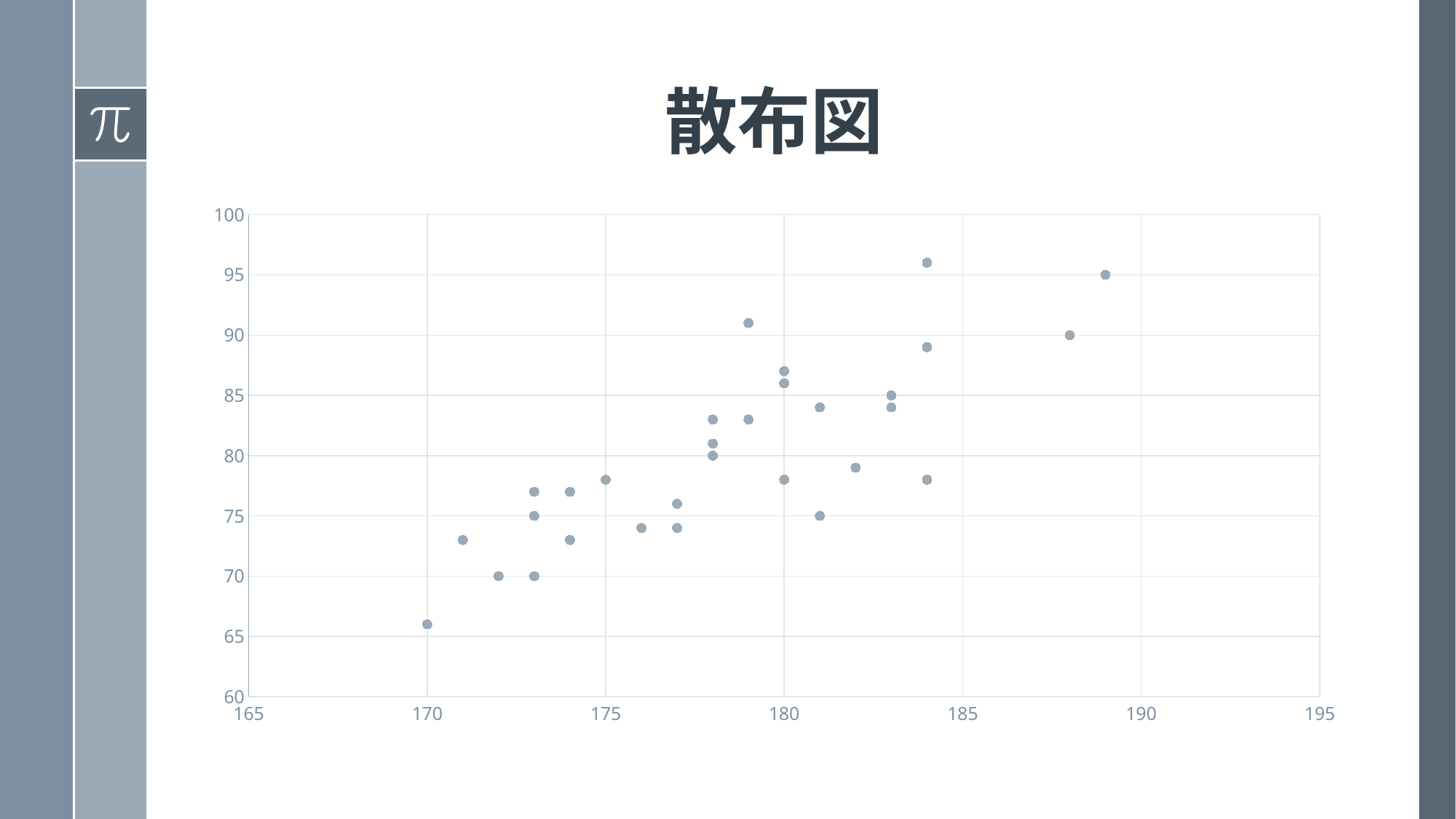
Are there any points plotted with a y value less than 65? No Is the x value of the rightmost point on the chart greater or less than 185? greater Is the x value of the leftmost point on the chart greater or less than 175? less What is the title of the chart? 散布図 Do the plotted y values generally rise or fall as the x value increases? rise What kind of chart is shown on the slide? scatter chart What is the maximum value shown on the vertical axis? 100